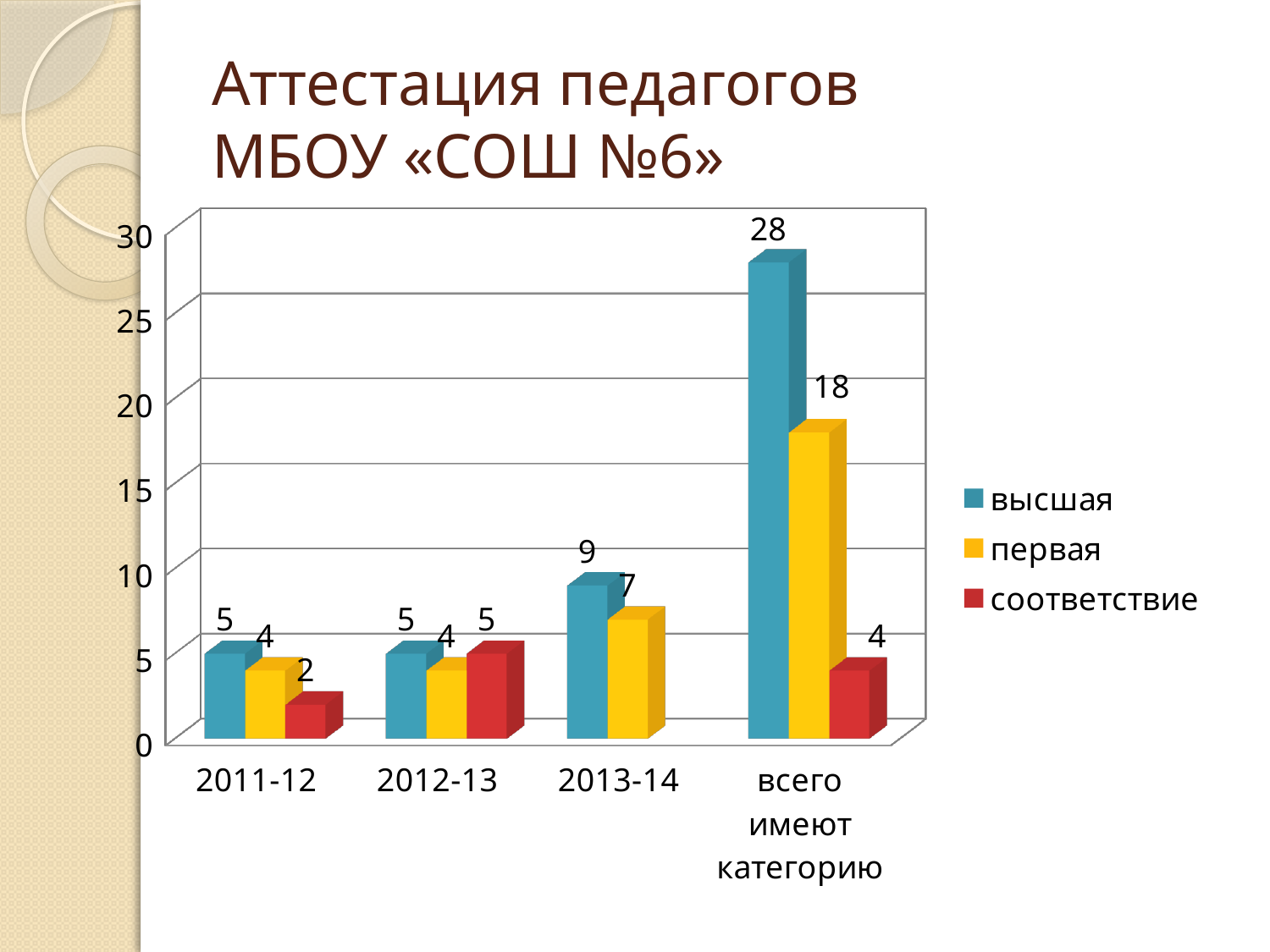
What is the value for высшая in the всего имеют категорию category? 28 What is the value for первая in 2013-14? 7 How many categories are shown on the x axis? 4 What is the value for соответствие in 2011-12? 2 Which category has the highest value for первая? всего имеют категорию What kind of chart is shown on the slide? bar chart Which is larger in 2013-14: высшая or первая? высшая How many series does the legend list? 3 What is the difference between высшая and первая in the всего имеют категорию category? 10 Which series is shown in red in the legend? соответствие What is the value for соответствие in 2012-13? 5 Which category has the lowest value for соответствие? 2011-12